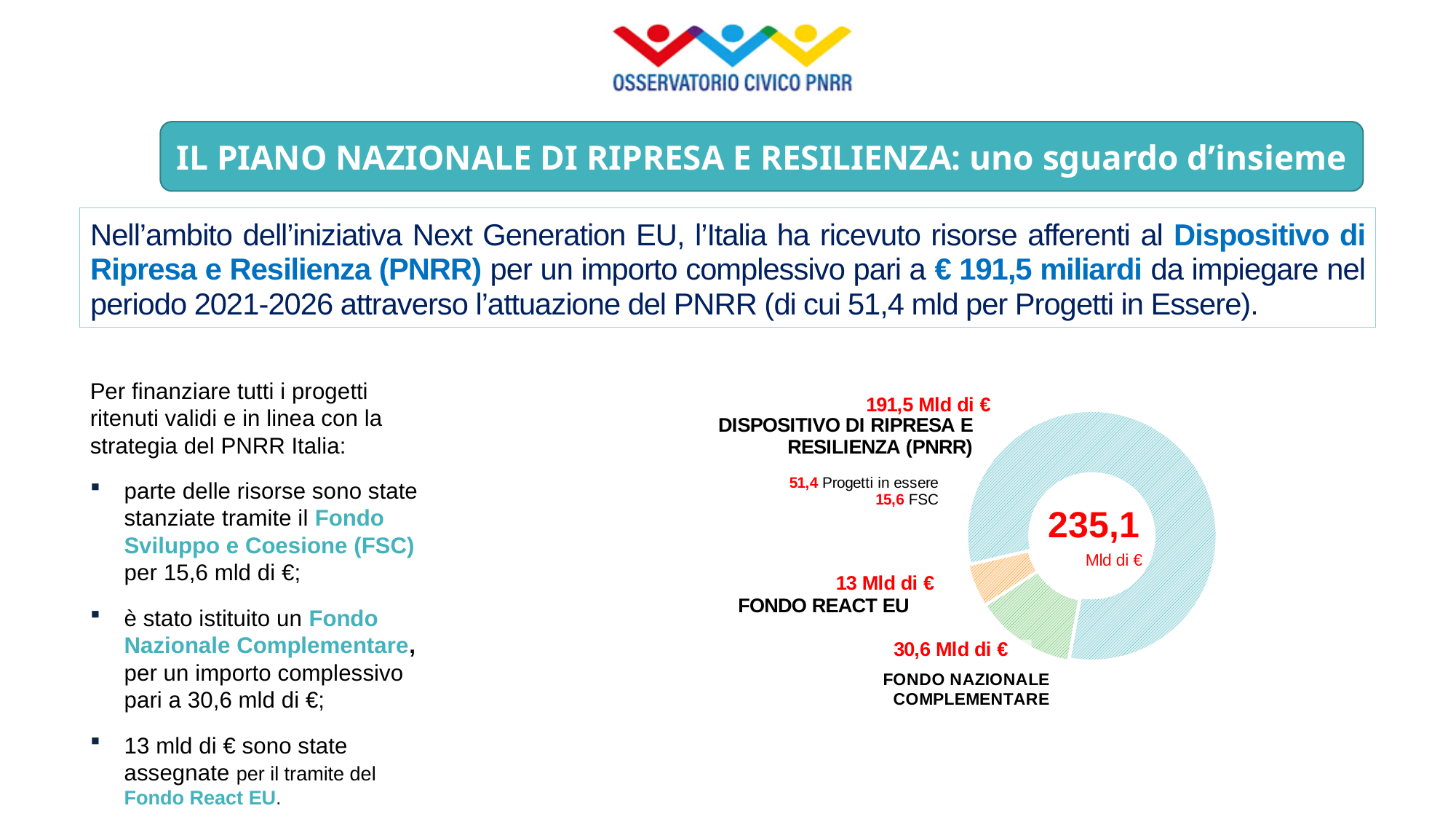
How many slices does the donut chart have? 3 Which slice of the chart is the smallest? FONDO REACT EU What is the difference between the FONDO NAZIONALE COMPLEMENTARE value and the FONDO REACT EU value? 17,6 Mld di € What total value is shown in the centre of the donut chart? 235,1 Mld di € What kind of chart is shown on the slide? Pie (donut) chart What is the difference between the PNRR value and the FONDO NAZIONALE COMPLEMENTARE value in the chart? 160,9 Mld di € What value is shown for FONDO REACT EU in the chart? 13 Mld di € What amount is labelled as 'Progetti in essere' within the PNRR slice? 51,4 Which slice of the chart is the largest? DISPOSITIVO DI RIPRESA E RESILIENZA (PNRR) Which is larger in the chart: FONDO REACT EU or FONDO NAZIONALE COMPLEMENTARE? FONDO NAZIONALE COMPLEMENTARE What value is shown for FONDO NAZIONALE COMPLEMENTARE in the chart? 30,6 Mld di € What value is shown for DISPOSITIVO DI RIPRESA E RESILIENZA (PNRR) in the chart? 191,5 Mld di €